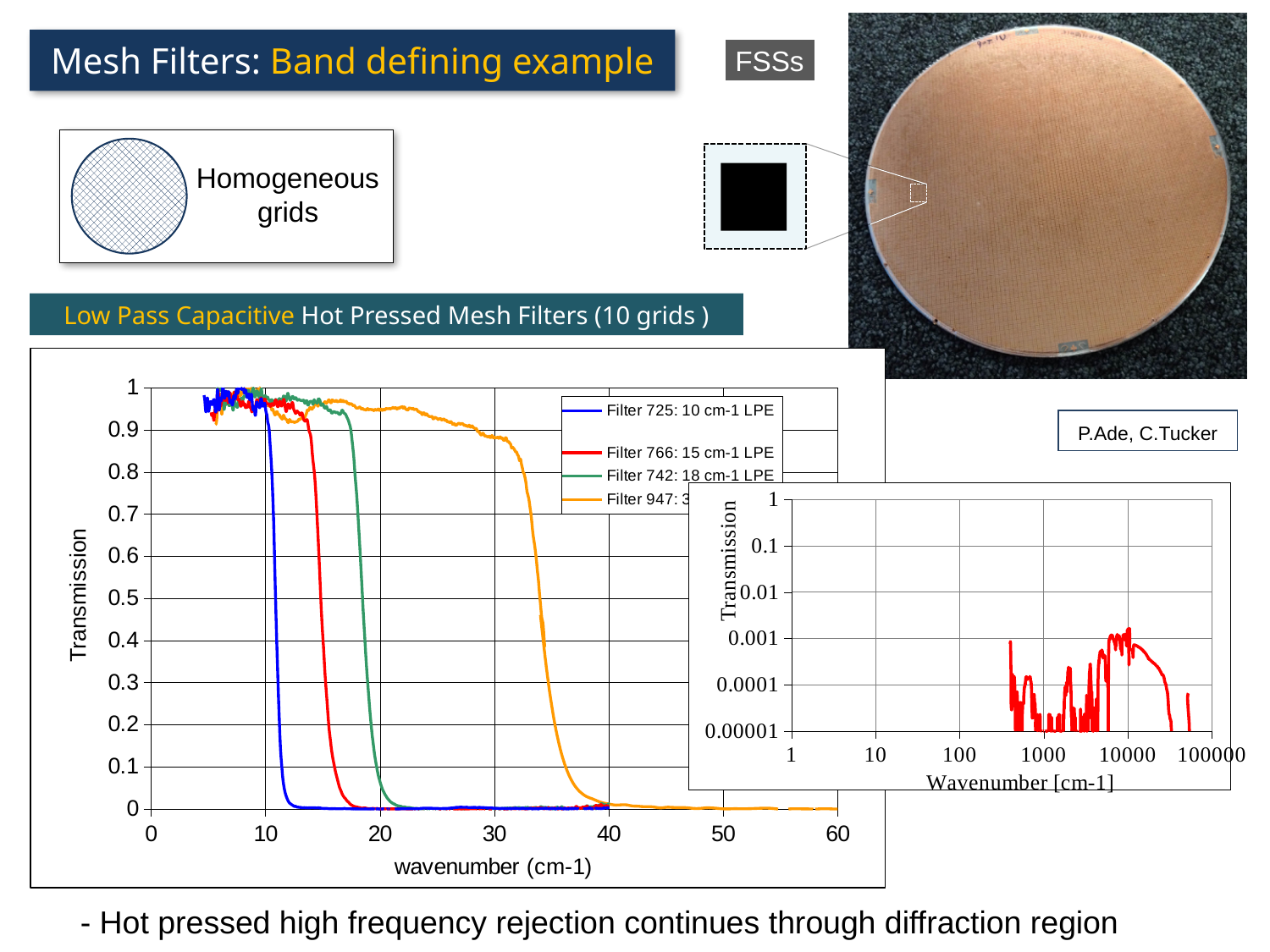
In the large chart with the x axis labelled 'wavenumber (cm-1)', does the transmission of 'Filter 766: 15 cm-1 LPE' rise or fall as the wavenumber increases from 10 to 20? fall In the large chart with the x axis labelled 'wavenumber (cm-1)', what colour is the line for 'Filter 766: 15 cm-1 LPE'? red In the large chart with the x axis labelled 'wavenumber (cm-1)', is the transmission of 'Filter 725: 10 cm-1 LPE' at a wavenumber of 20 greater or less than 0.1? less In the large chart with the x axis labelled 'wavenumber (cm-1)', which line drops to zero transmission at the highest wavenumber? the orange line In the inset chart with the x axis labelled 'Wavenumber [cm-1]', is the transmission at a wavenumber of 10000 greater or less than 0.01? less In the large chart with the x axis labelled 'wavenumber (cm-1)', how many series does the legend list? 4 In the large chart with the x axis labelled 'wavenumber (cm-1)', which line is larger at a wavenumber of 15: 'Filter 725: 10 cm-1 LPE' or 'Filter 742: 18 cm-1 LPE'? Filter 742: 18 cm-1 LPE In the inset chart with the x axis labelled 'Wavenumber [cm-1]', what is the highest tick value shown on the x axis? 100000 In the large chart with the x axis labelled 'wavenumber (cm-1)', is the transmission of 'Filter 742: 18 cm-1 LPE' at a wavenumber of 10 greater or less than 0.9? greater In the large chart with the x axis labelled 'wavenumber (cm-1)', what is the label of the y axis? Transmission What kind of chart is the large chart with the x axis labelled 'wavenumber (cm-1)'? line chart